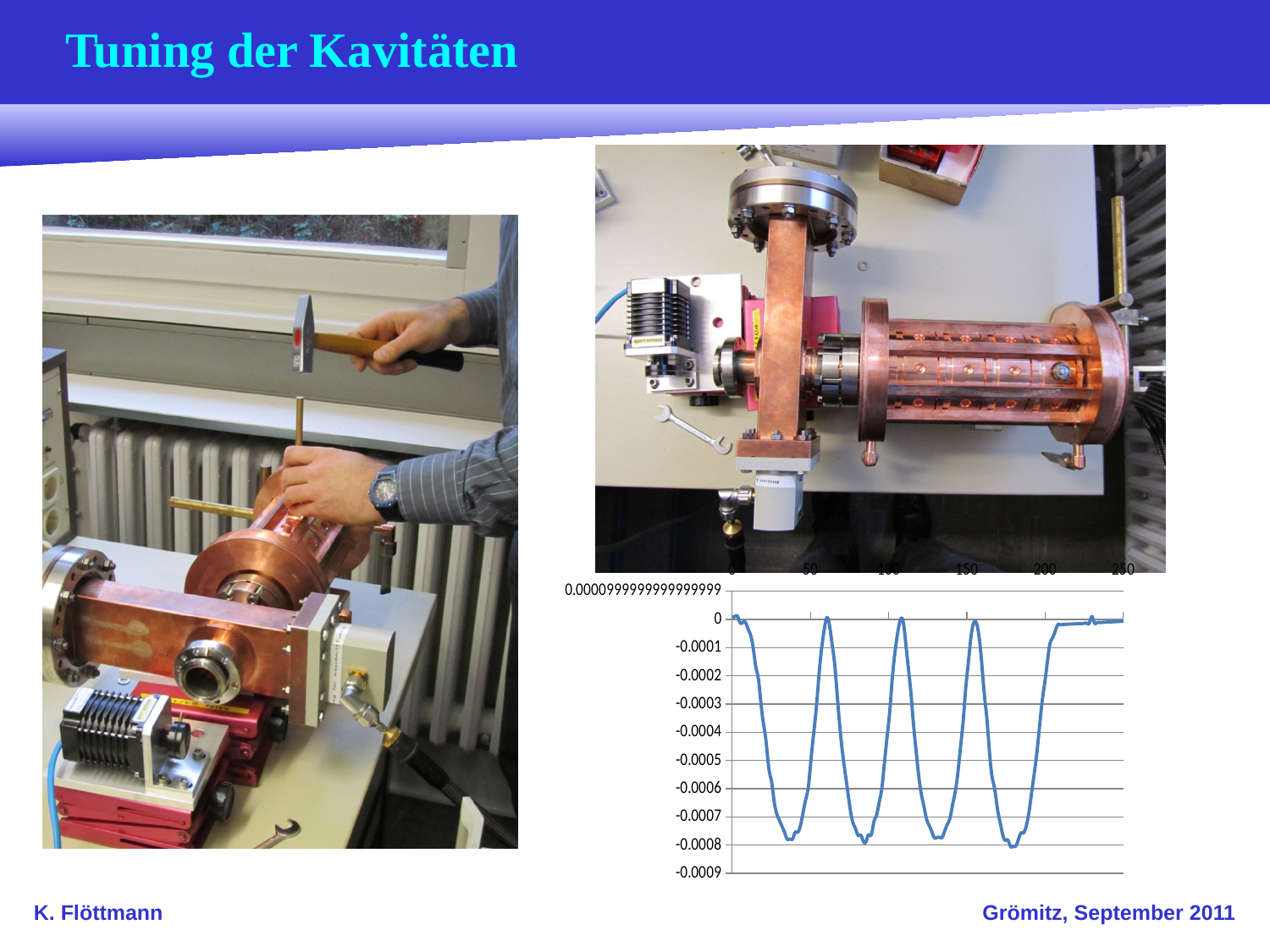
In the line chart at the bottom right, is the value at x = 0 greater or less than -0.0004? greater In the line chart at the bottom right, how many dips (minima) does the curve show below -0.0007? 4 In the line chart at the bottom right, what is the lowest value labelled on the y axis? -0.0009 In the line chart at the bottom right, is the value at x = 200 greater or less than -0.0004? greater In the line chart at the bottom right, is the value at x = 250 greater or less than -0.0004? greater What kind of chart is shown at the bottom right of the slide? line chart In the line chart at the bottom right, what is the largest value shown on the x axis? 250